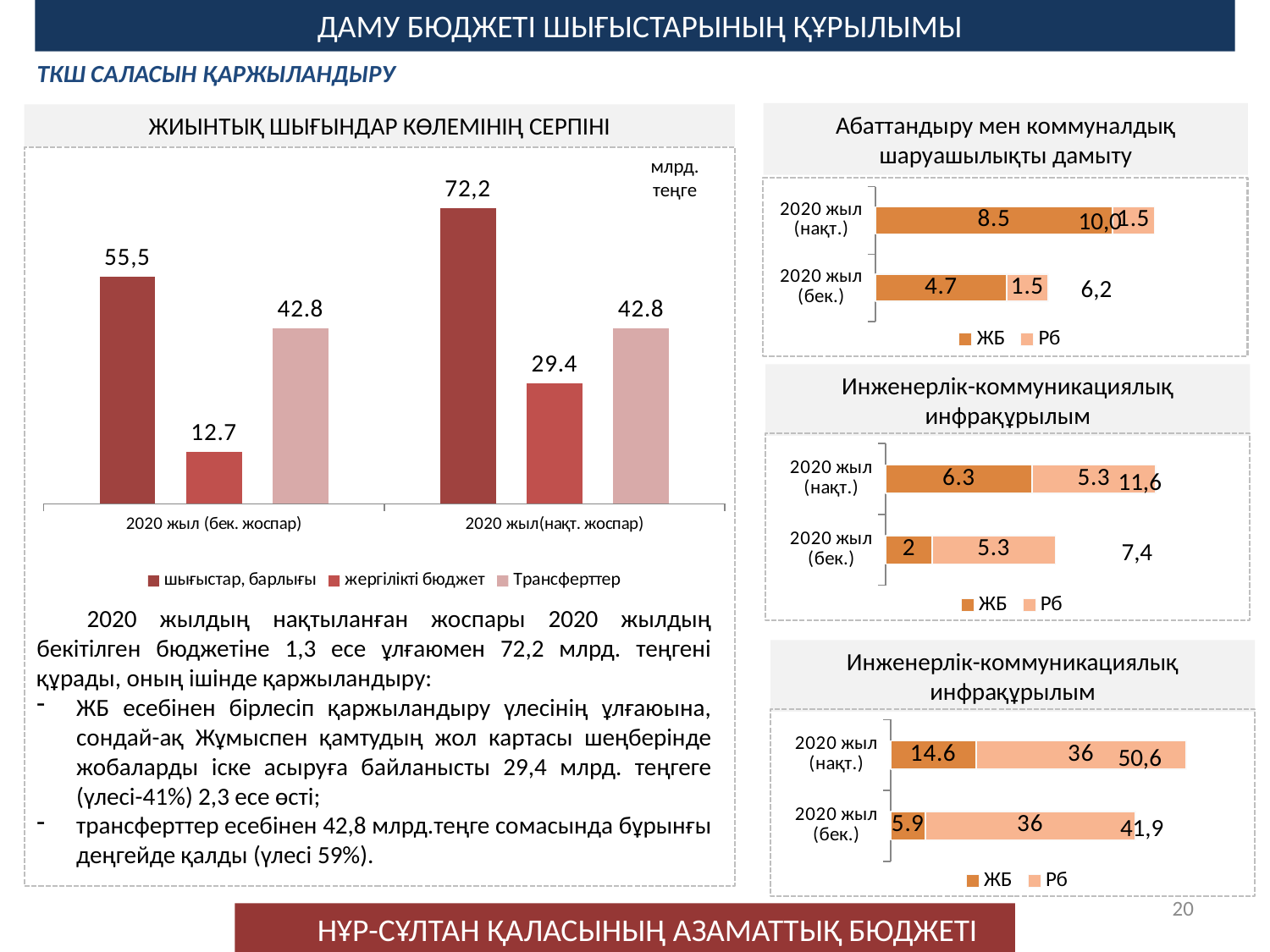
In the bottom chart on the right titled 'Инженерлік-коммуникациялық инфрақұрылым', what is the 'ЖБ' value for '2020 жыл (бек.)'? 5.9 In the chart titled 'ЖИЫНТЫҚ ШЫҒЫНДАР КӨЛЕМІНІҢ СЕРПІНІ', what is the value of 'шығыстар, барлығы' for '2020 жыл(нақт. жоспар)'? 72,2 In the chart titled 'Абаттандыру мен коммуналдық шаруашылықты дамыту', what is the 'ЖБ' value for '2020 жыл (нақт.)'? 8.5 In the chart titled 'ЖИЫНТЫҚ ШЫҒЫНДАР КӨЛЕМІНІҢ СЕРПІНІ', which series has the lowest value for '2020 жыл (бек. жоспар)'? жергілікті бюджет In the chart titled 'ЖИЫНТЫҚ ШЫҒЫНДАР КӨЛЕМІНІҢ СЕРПІНІ', what is the value of 'жергілікті бюджет' for '2020 жыл (бек. жоспар)'? 12.7 What kind of chart is 'ЖИЫНТЫҚ ШЫҒЫНДАР КӨЛЕМІНІҢ СЕРПІНІ'? bar chart In the chart titled 'ЖИЫНТЫҚ ШЫҒЫНДАР КӨЛЕМІНІҢ СЕРПІНІ', how many series does the legend list? 3 In the chart titled 'Абаттандыру мен коммуналдық шаруашылықты дамыту', what is the total of the stacked bar for '2020 жыл (бек.)'? 6,2 In the chart titled 'ЖИЫНТЫҚ ШЫҒЫНДАР КӨЛЕМІНІҢ СЕРПІНІ', what is the difference between the 'жергілікті бюджет' values for '2020 жыл(нақт. жоспар)' and '2020 жыл (бек. жоспар)'? 16.7 In the middle chart on the right titled 'Инженерлік-коммуникациялық инфрақұрылым', what is the 'ЖБ' value for '2020 жыл (бек.)'? 2 In the middle chart on the right titled 'Инженерлік-коммуникациялық инфрақұрылым', which is larger for '2020 жыл (нақт.)': 'ЖБ' or 'Рб'? ЖБ In the bottom chart on the right titled 'Инженерлік-коммуникациялық инфрақұрылым', what is the total of the stacked bar for '2020 жыл (нақт.)'? 50,6